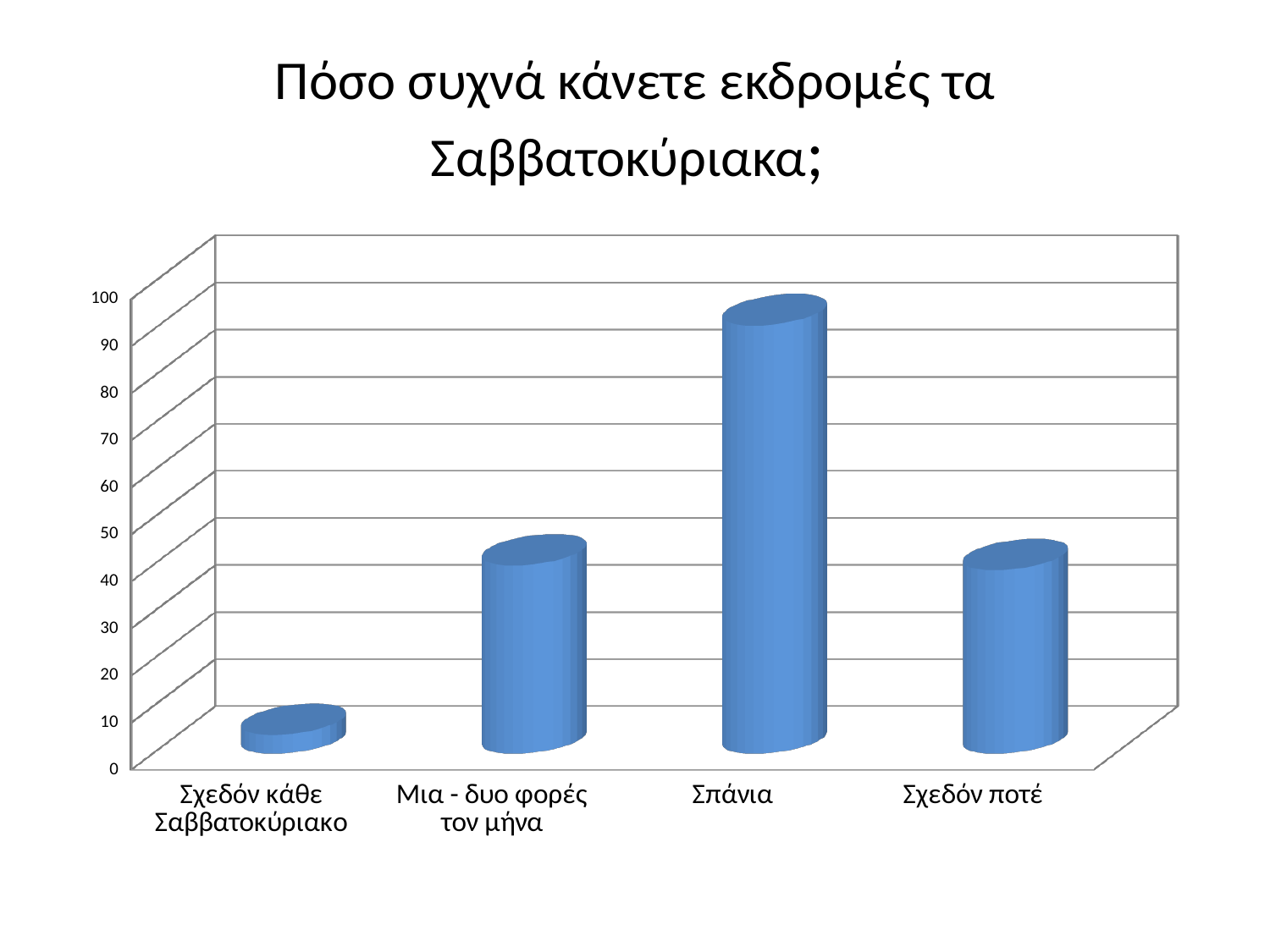
Is the value for Μια - δυο φορές τον μήνα greater or less than 30? greater Which category has the lowest value? Σχεδόν κάθε Σαββατοκύριακο Which is larger, the value for Μια - δυο φορές τον μήνα or the value for Σχεδόν κάθε Σαββατοκύριακο? Μια - δυο φορές τον μήνα Is the value for Σπάνια greater or less than 80? greater What is the highest value shown on the vertical axis of the chart? 100 What kind of chart is shown on the slide? bar chart What is the title of the chart on the slide? Πόσο συχνά κάνετε εκδρομές τα Σαββατοκύριακα; Is the value for Σχεδόν κάθε Σαββατοκύριακο greater or less than 20? less Which category has the highest value? Σπάνια How many categories are shown on the x axis of the chart? 4 Which is larger, the value for Σπάνια or the value for Σχεδόν ποτέ? Σπάνια